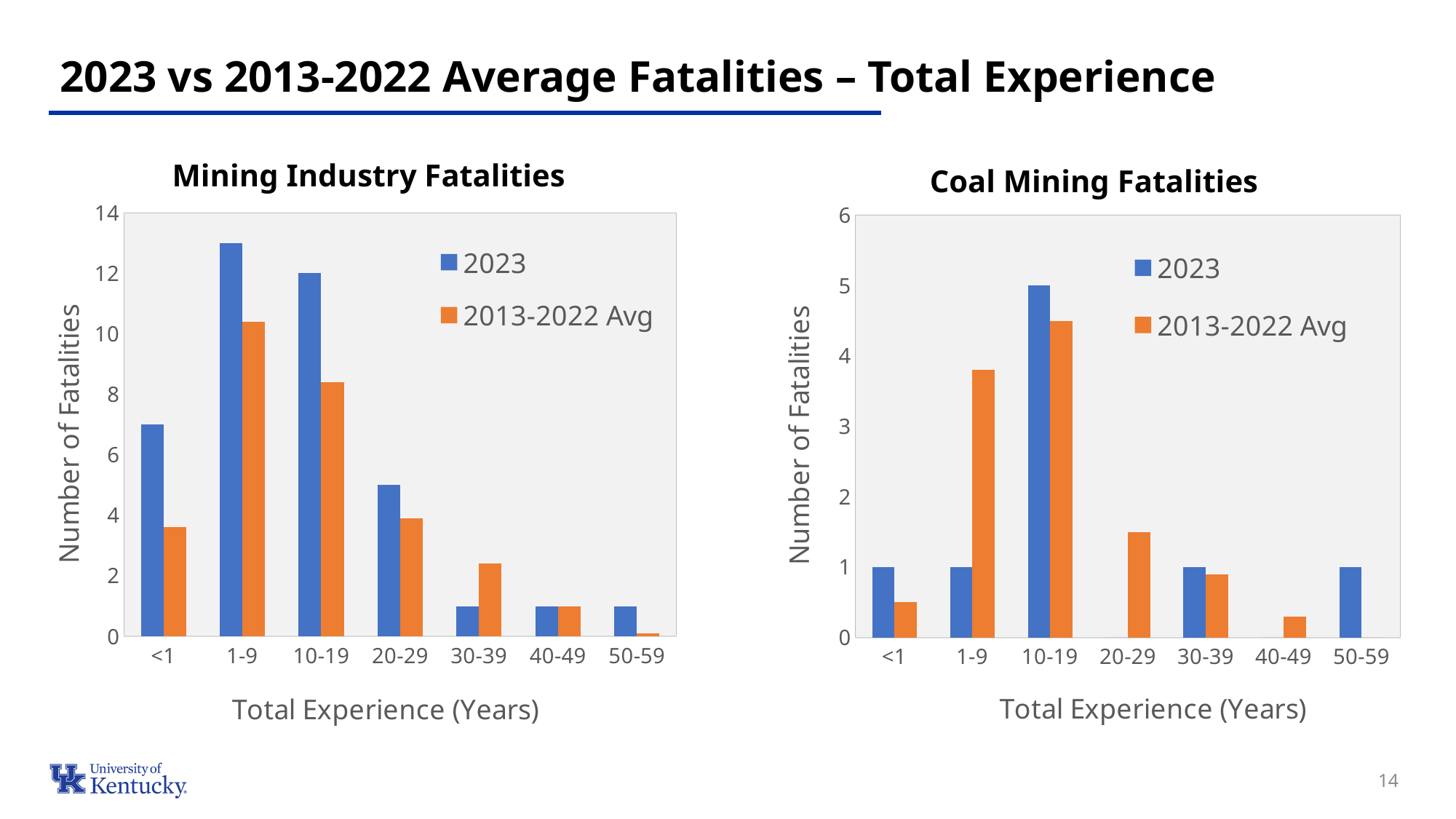
In the Coal Mining Fatalities chart, which is larger for the 20-29 group, the 2023 value or the 2013-2022 Avg value? 2013-2022 Avg In the Mining Industry Fatalities chart, is the 2023 value for the <1 group greater or less than 6? greater In the Mining Industry Fatalities chart, which is larger for the 30-39 group, the 2023 value or the 2013-2022 Avg value? 2013-2022 Avg How many experience categories are shown on the x axis of the Mining Industry Fatalities chart? 7 In the Mining Industry Fatalities chart, which experience group has the highest 2023 value? 1-9 In the Mining Industry Fatalities chart, is the 2013-2022 Avg value for the 1-9 group greater or less than 8? greater In the Coal Mining Fatalities chart, what is the 2023 value for the 10-19 years experience group? 5 In the Coal Mining Fatalities chart, is the 2013-2022 Avg value for the 1-9 group greater or less than 3? greater In the Coal Mining Fatalities chart, which experience group has the highest 2023 value? 10-19 In the Mining Industry Fatalities chart, what is the 2023 value for the 10-19 years experience group? 12 What type of chart is the Coal Mining Fatalities chart? Bar chart How many series does the legend of the Coal Mining Fatalities chart list? 2